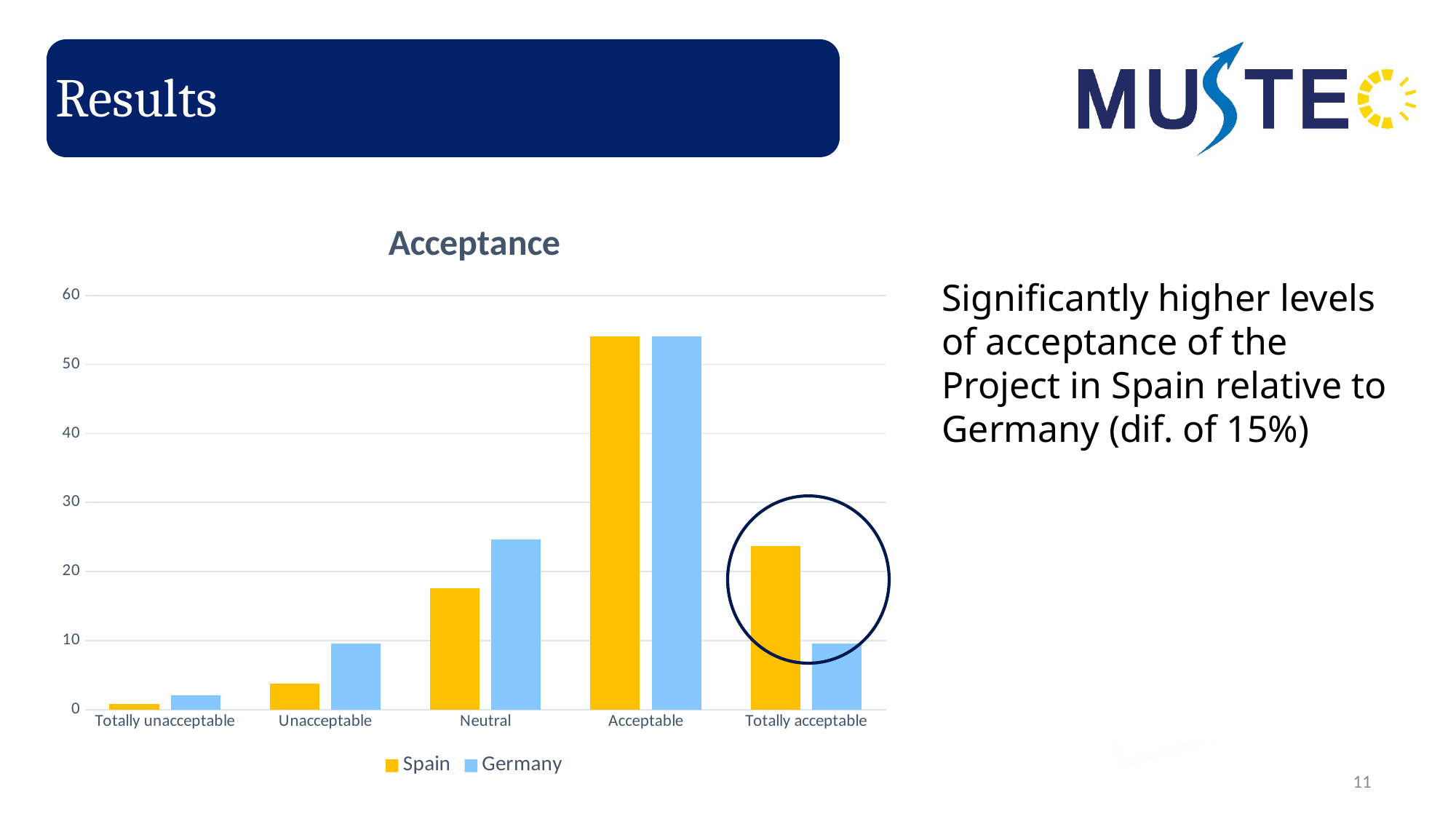
Is the value for Spain in the Acceptable category greater or less than 50? greater Which category has the lowest value for Germany? Totally unacceptable Which category has the highest value for Spain? Acceptable For the Neutral category, which series has the larger value, Spain or Germany? Germany How many categories are shown on the x axis? 5 What is the title of the chart? Acceptance For the Totally acceptable category, which series has the larger value, Spain or Germany? Spain How many series does the legend list? 2 What kind of chart is shown on the slide? bar chart Which colour represents Germany in the chart? light blue Is the value for Spain in the Neutral category greater or less than 20? less Is the value for Germany in the Totally acceptable category greater or less than 20? less